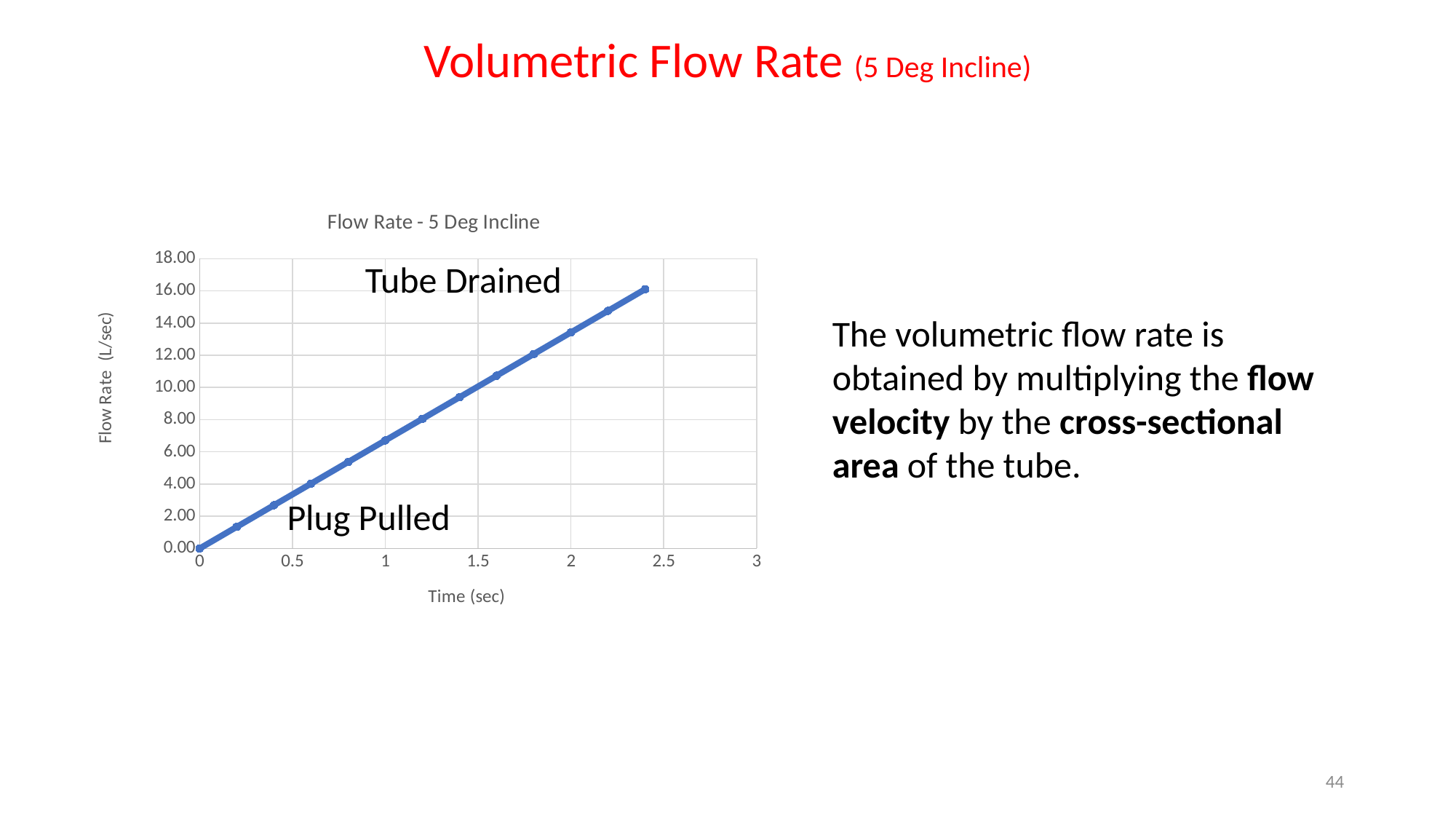
Which time has the highest flow rate, 2.4 sec or 1.2 sec? 2.4 sec Is the flow rate at 0.2 sec greater or less than 2.00? less What kind of chart is shown on the slide? line chart Is the flow rate at 1 sec greater or less than 6.00? greater Is the flow rate at 2 sec greater or less than 12.00? greater What is the flow rate at time 0 sec? 0.00 How many data points are plotted on the line? 13 Does the flow rate rise or fall as time increases? rises What is the label of the y axis? Flow Rate (L/sec) What is the title of the chart? Flow Rate - 5 Deg Incline